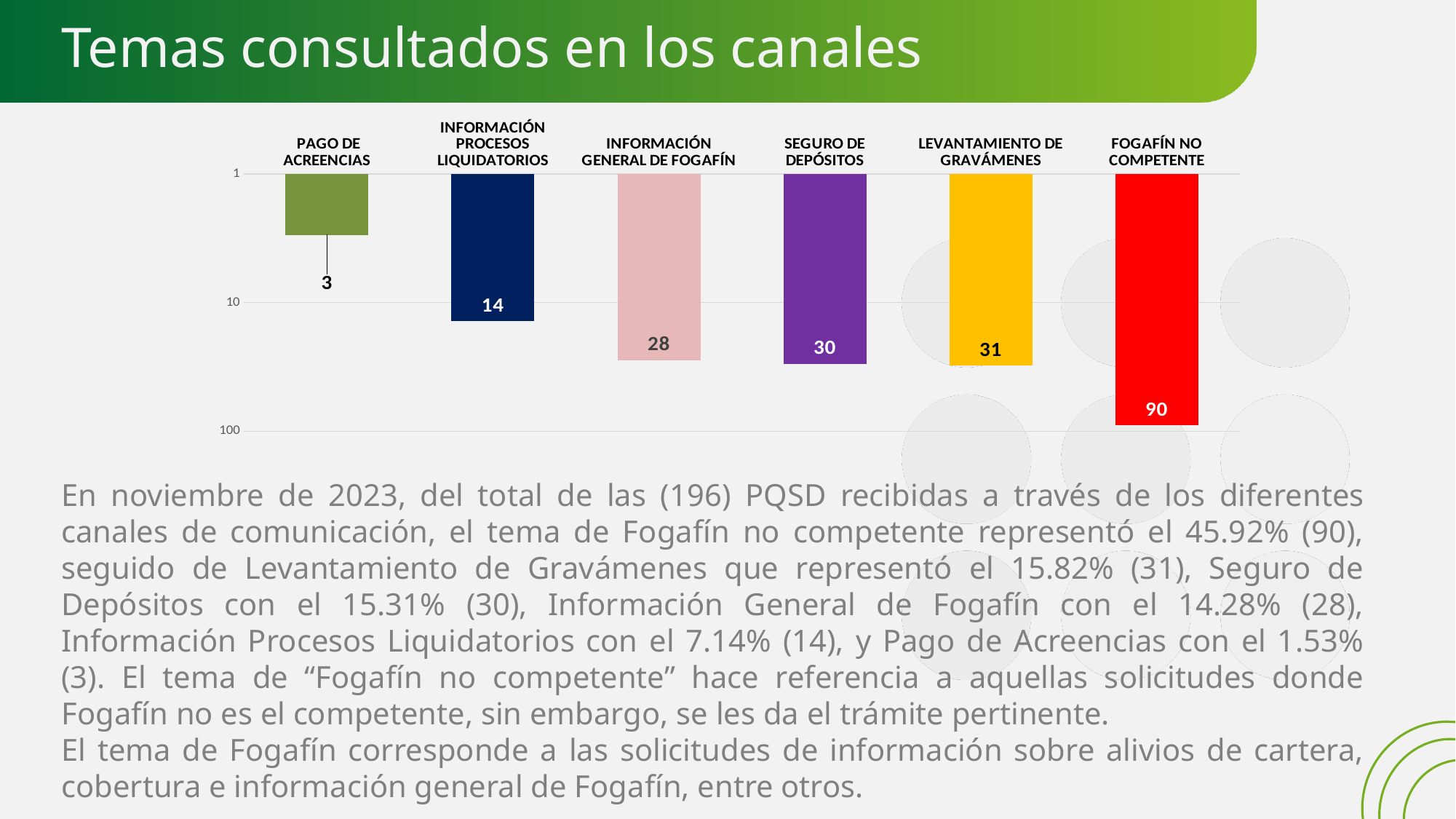
What is the value for INFORMACIÓN PROCESOS LIQUIDATORIOS? 14 What is the value for PAGO DE ACREENCIAS? 3 What kind of chart is shown on the slide? Bar chart What is the difference between the values for FOGAFÍN NO COMPETENTE and LEVANTAMIENTO DE GRAVÁMENES? 59 Which is larger, the value for SEGURO DE DEPÓSITOS or the value for PAGO DE ACREENCIAS? SEGURO DE DEPÓSITOS Which category has the highest value? FOGAFÍN NO COMPETENTE What is the difference between the values for INFORMACIÓN GENERAL DE FOGAFÍN and INFORMACIÓN PROCESOS LIQUIDATORIOS? 14 What is the value for SEGURO DE DEPÓSITOS? 30 Which category has the lowest value? PAGO DE ACREENCIAS What is the value for FOGAFÍN NO COMPETENTE? 90 How many categories are shown in the chart? 6 What is the title of the slide containing the chart? Temas consultados en los canales